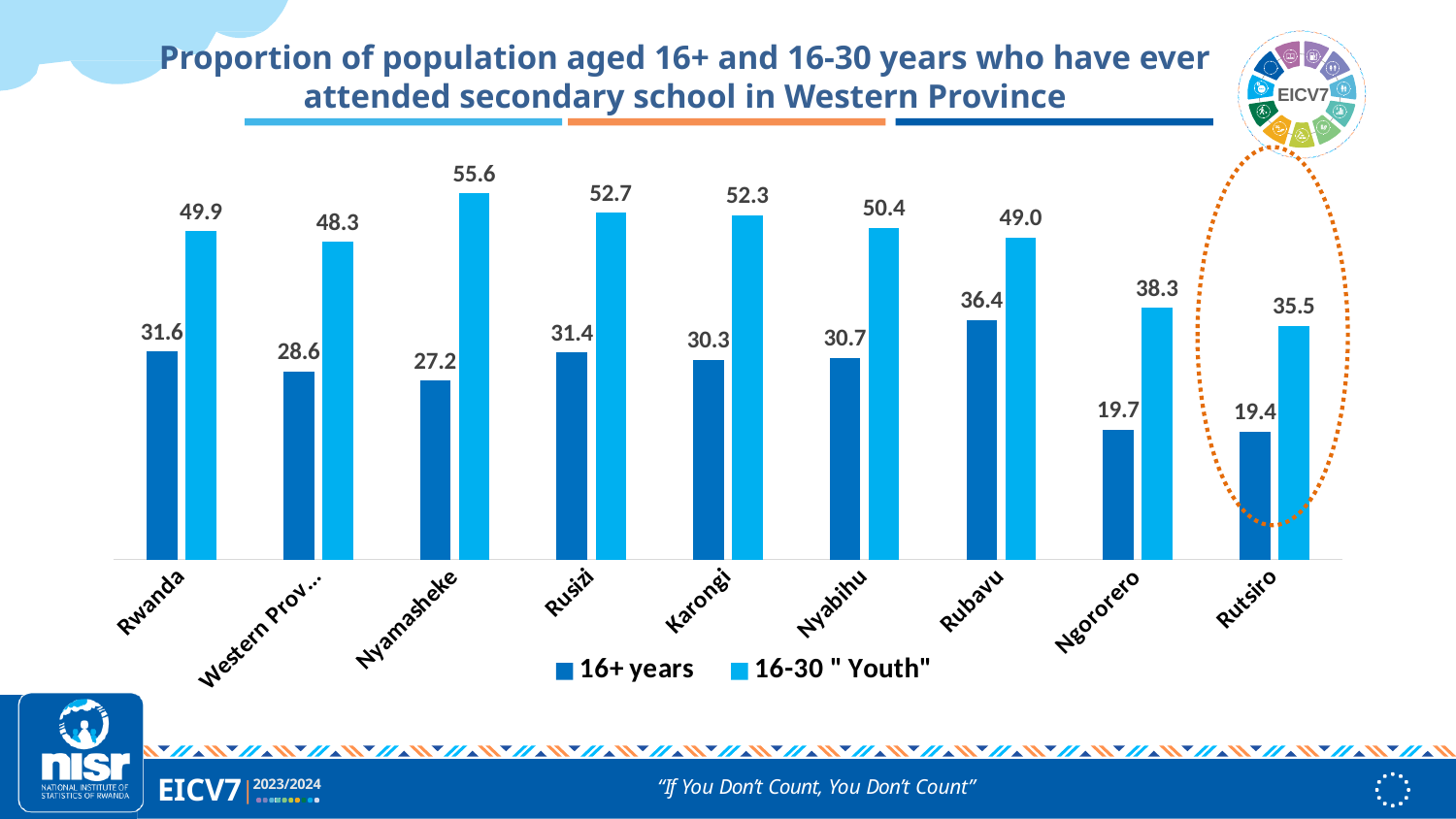
Which category is highlighted with a dotted orange oval? Rutsiro What is the difference between the 16-30 "Youth" value and the 16+ years value for Rwanda? 18.3 How many series does the legend list? 2 Which is larger: the 16+ years value for Rubavu or the 16+ years value for Nyabihu? Rubavu Which category has the highest value in the 16-30 "Youth" series? Nyamasheke What kind of chart is shown on the slide? Bar chart How many categories are shown on the x axis? 9 What is the value for Rutsiro in the 16-30 "Youth" series? 35.5 Which category has the lowest value in the 16+ years series? Rutsiro What is the value for Rubavu in the 16+ years series? 36.4 What is the value for Nyamasheke in the 16-30 "Youth" series? 55.6 What is the value for Ngororero in the 16+ years series? 19.7